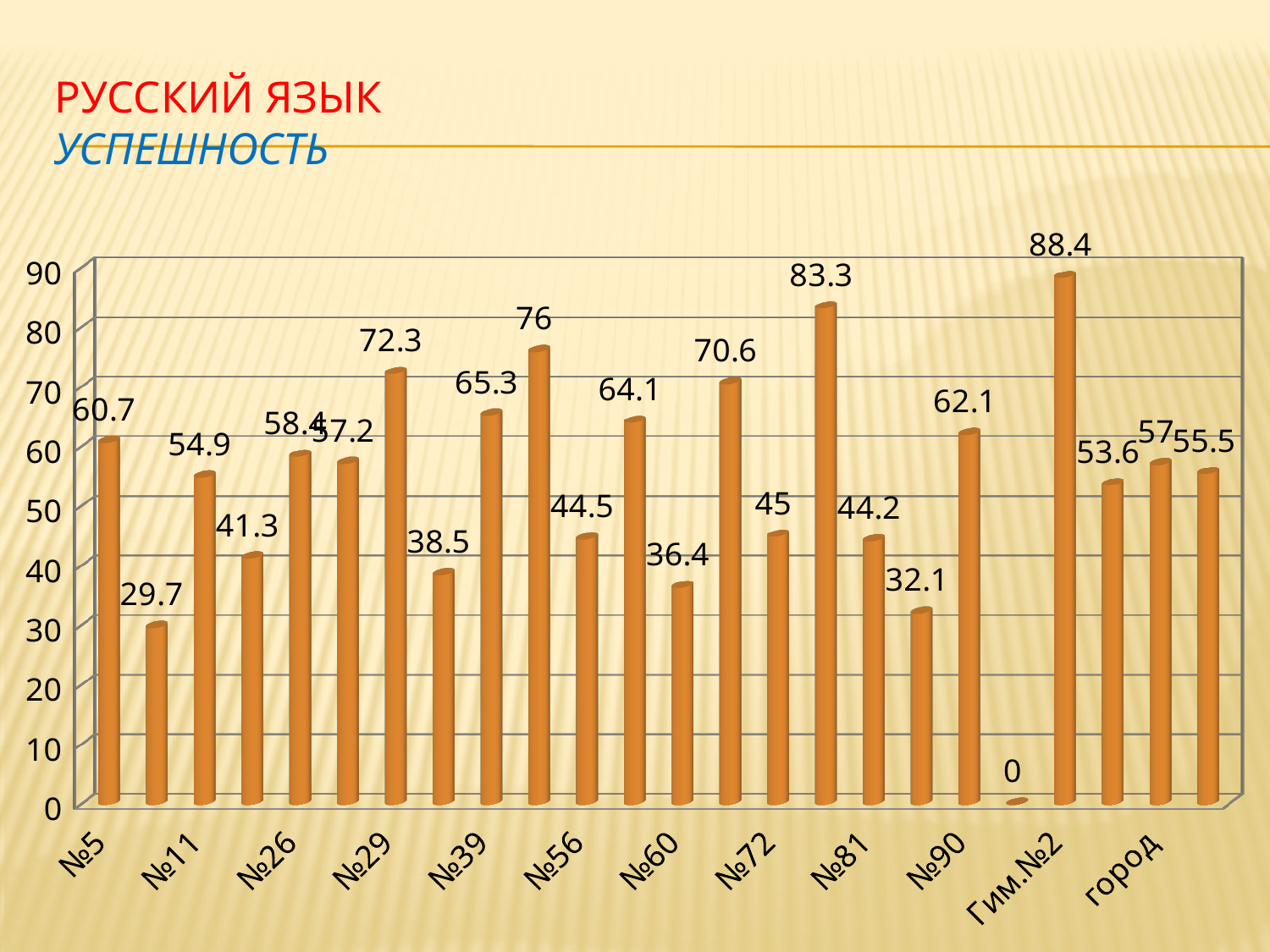
What is the value for №29? 72.3 Is the value for №90 greater or less than 40? greater What is the difference between the values for Гим.№2 and №5? 27.7 What is the highest value shown on the chart? 88.4 Which is larger, the value for №29 or the value for №39? №29 What kind of chart is shown on the slide? bar chart What is the value for №5? 60.7 What is the lowest value shown on the chart? 0 What is the value for город? 57 Which category has the highest value? Гим.№2 How many bars are plotted on the chart? 24 What is the value for Гим.№2? 88.4